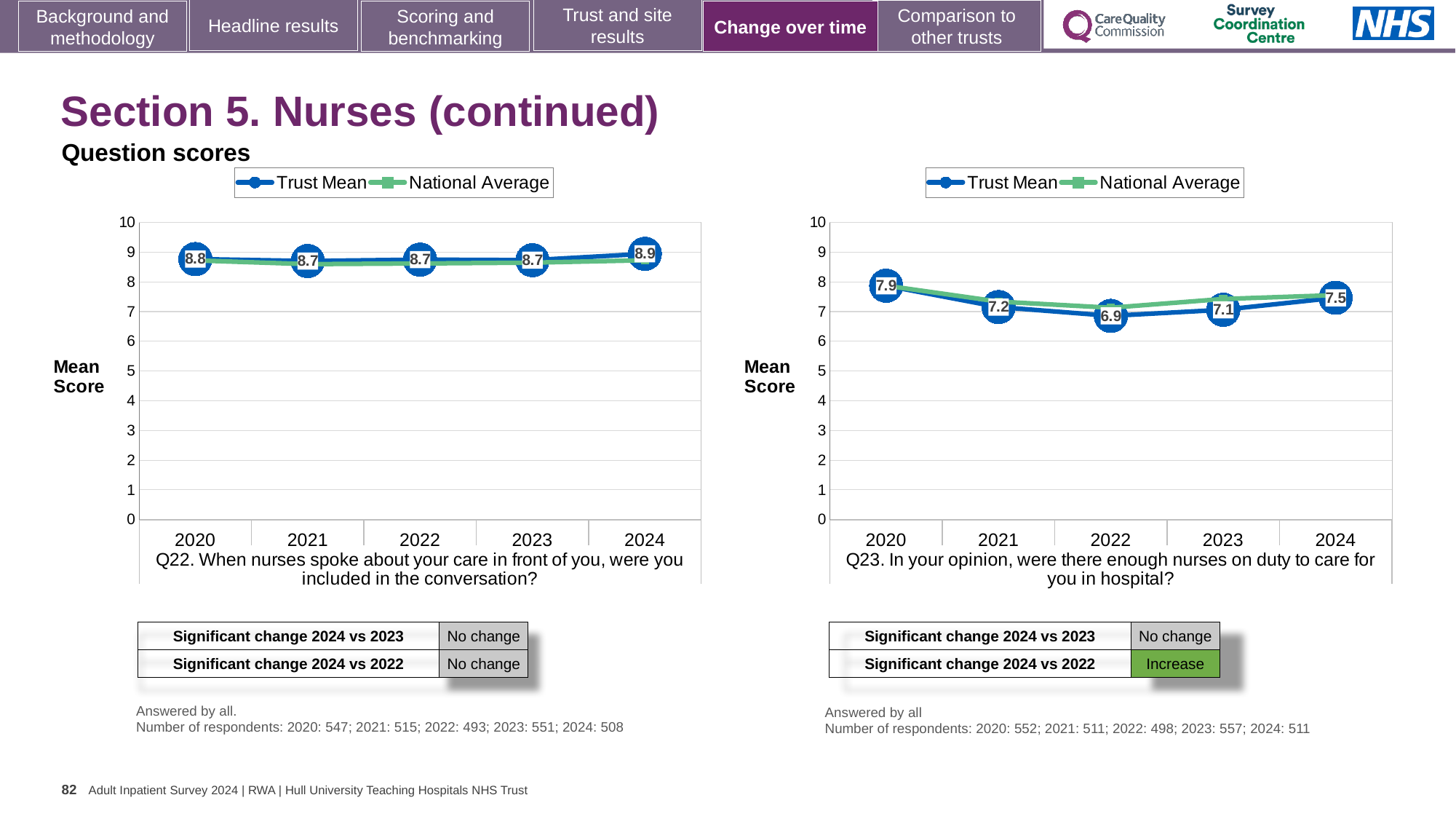
How many series does the legend of the Q23 chart (right) list? 2 In the Q22 chart (left), what is the Trust Mean score for 2024? 8.9 In the Q22 chart (left), what is the Trust Mean score for 2020? 8.8 In the Q22 chart (left), which is larger, the Trust Mean score for 2024 or for 2021? 2024 In the Q23 chart (right), what is the Trust Mean score for 2022? 6.9 In the Q23 chart (right), is the National Average for 2020 greater or less than 5? greater In the Q23 chart (right), which year has the lowest Trust Mean score? 2022 In the Q23 chart (right), what is the Trust Mean score for 2024? 7.5 What kind of chart is the Q22 chart (left)? Line chart In the Q23 chart (right), which year has the highest Trust Mean score? 2020 In the Q23 chart (right), what is the difference between the Trust Mean scores for 2020 and 2022? 1.0 How many years are plotted on the x axis of the Q22 chart (left)? 5